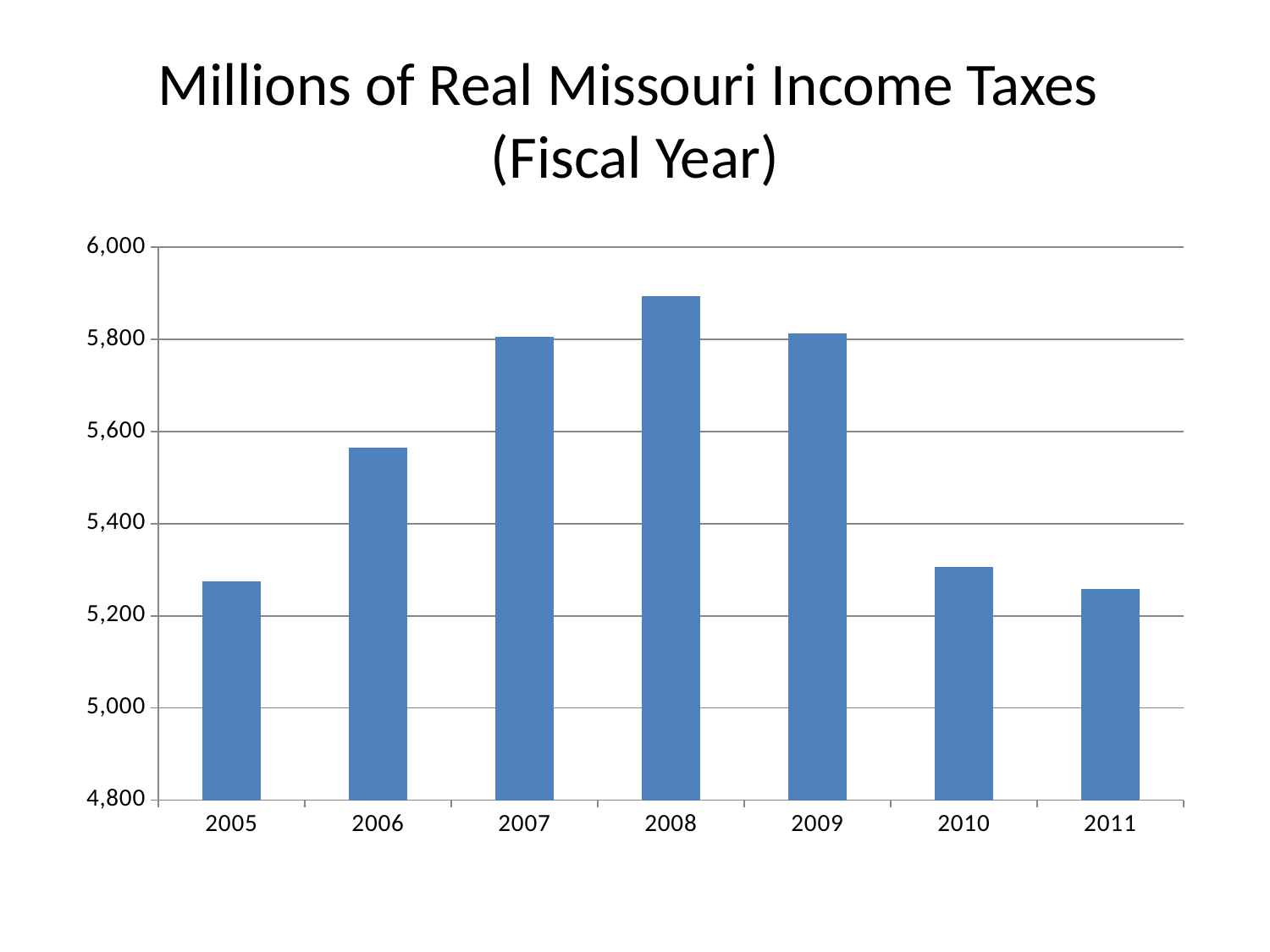
Which fiscal year has the highest value? 2008 Is the value for 2010 greater or less than 5,400? less How many fiscal years are shown on the x axis? 7 Is the value for 2006 greater or less than 5,400? greater Is the value for 2005 greater or less than 5,200? greater Which is larger, the value for 2006 or the value for 2010? 2006 What kind of chart is shown on the slide? bar chart Do the values rise or fall from 2005 to 2008? rise Which is larger, the value for 2008 or the value for 2011? 2008 What is the title of the chart? Millions of Real Missouri Income Taxes (Fiscal Year)